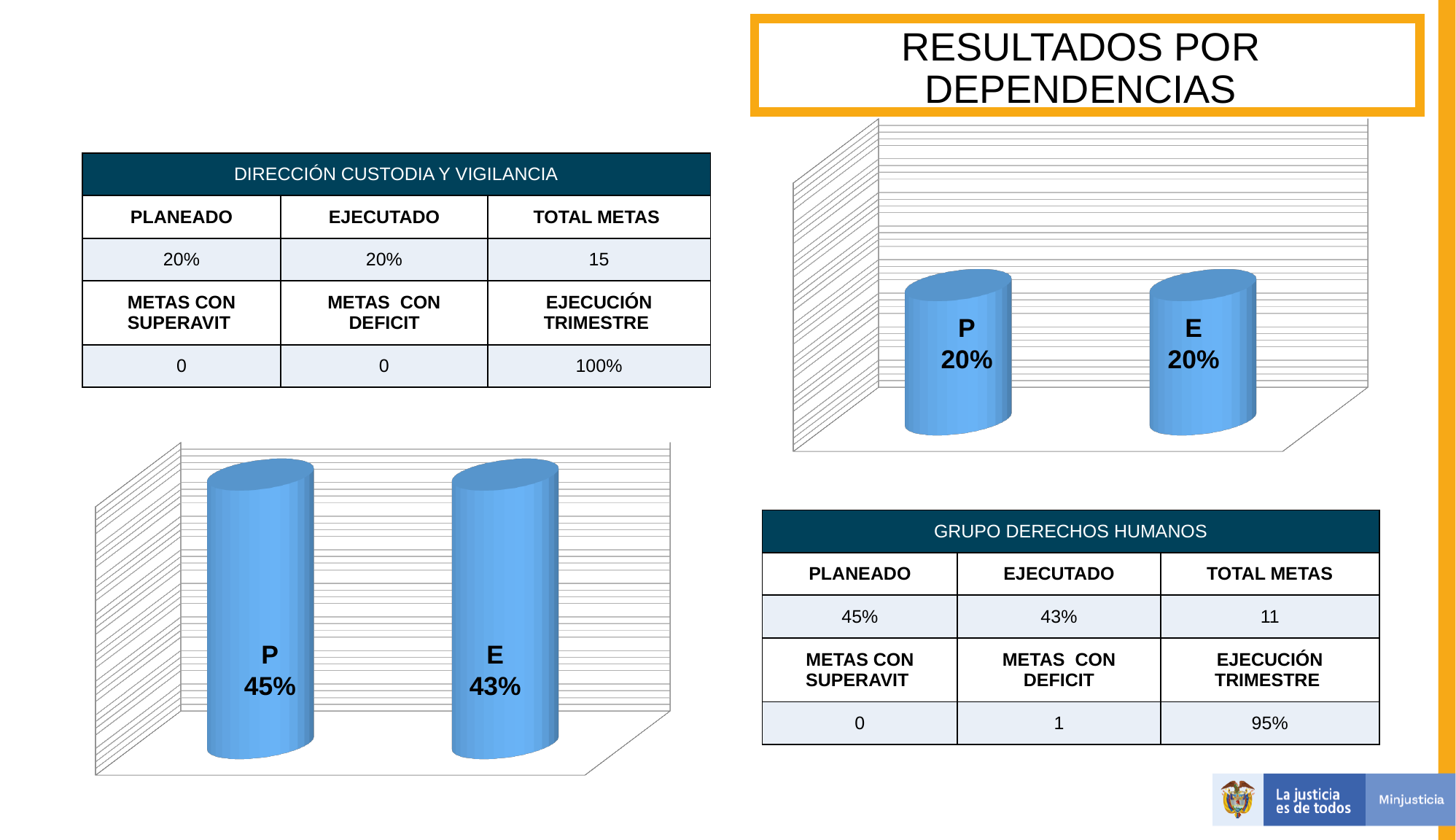
In the chart at the top right of the slide, what is the difference between the values for P and E? 0% In the chart at the bottom left of the slide, do the values rise or fall from P to E? Fall What colour are the bars in the chart at the top right of the slide? Blue In the chart at the top right of the slide, what is the value for P? 20% In the chart at the top right of the slide, what is the value for E? 20% In the chart at the bottom left of the slide, what is the difference between the values for P and E? 2% What kind of chart is shown at the bottom left of the slide? Bar chart In the chart at the bottom left of the slide, what is the value for E? 43% How many bars are shown in the chart at the bottom left of the slide? 2 In the chart at the bottom left of the slide, what is the value for P? 45% In the chart at the bottom left of the slide, which bar has the higher value, P or E? P How many bars are shown in the chart at the top right of the slide? 2